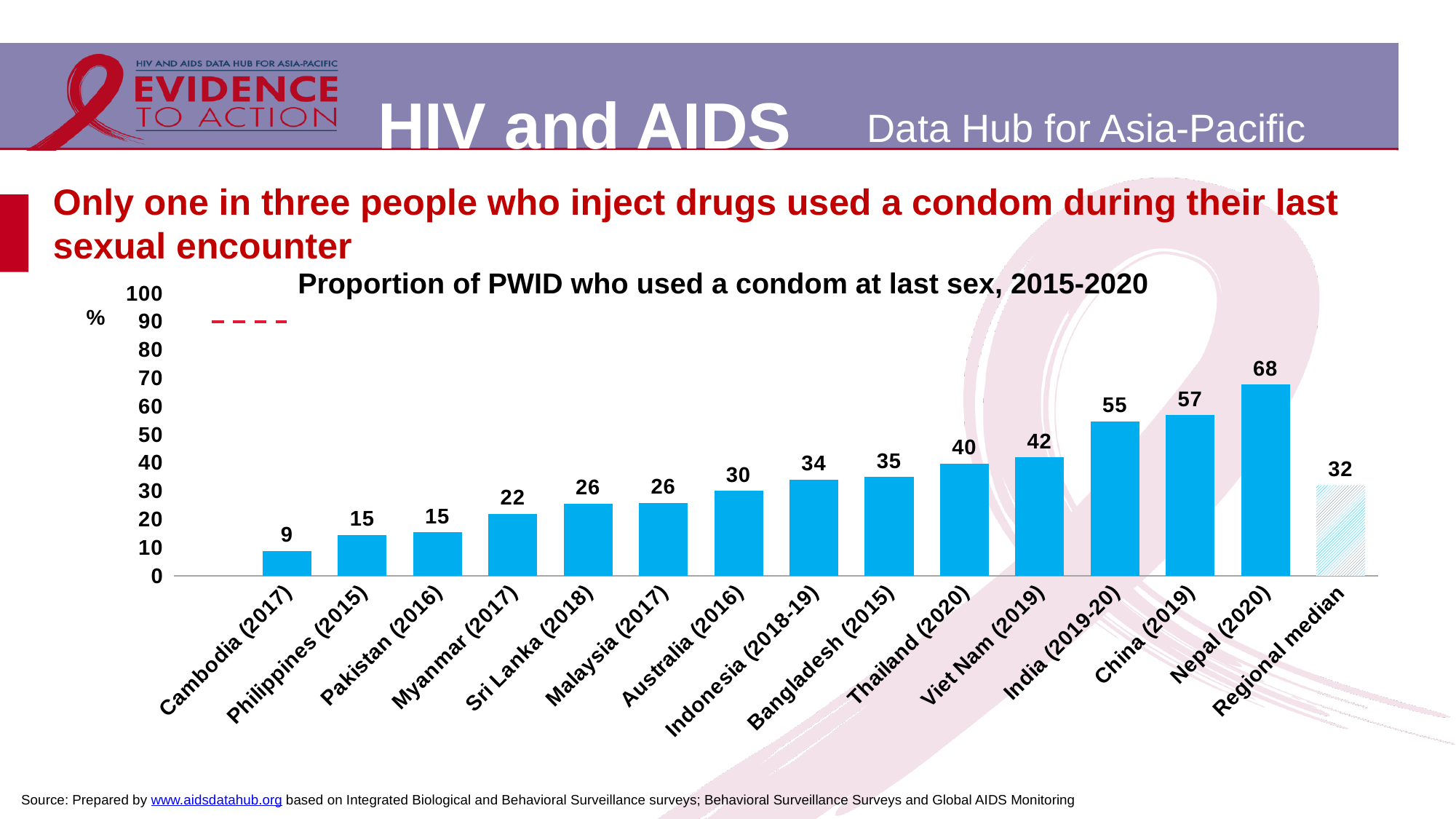
Which country has the highest proportion of PWID who used a condom at last sex? Nepal (2020) What kind of chart is shown on the slide? Bar chart What is the Regional median value shown on the chart? 32 Which is larger, the value for Thailand (2020) or the value for Bangladesh (2015)? Thailand (2020) How many bars are plotted on the chart, including the Regional median? 15 What is the difference between the values for China (2019) and India (2019-20)? 2 Do the country values rise or fall from left to right along the x axis? Rise What is the value for Nepal (2020)? 68 What is the value for Cambodia (2017)? 9 Is the value for Viet Nam (2019) greater or less than 50? less Which country has the lowest proportion of PWID who used a condom at last sex? Cambodia (2017) What is the title of the chart? Proportion of PWID who used a condom at last sex, 2015-2020